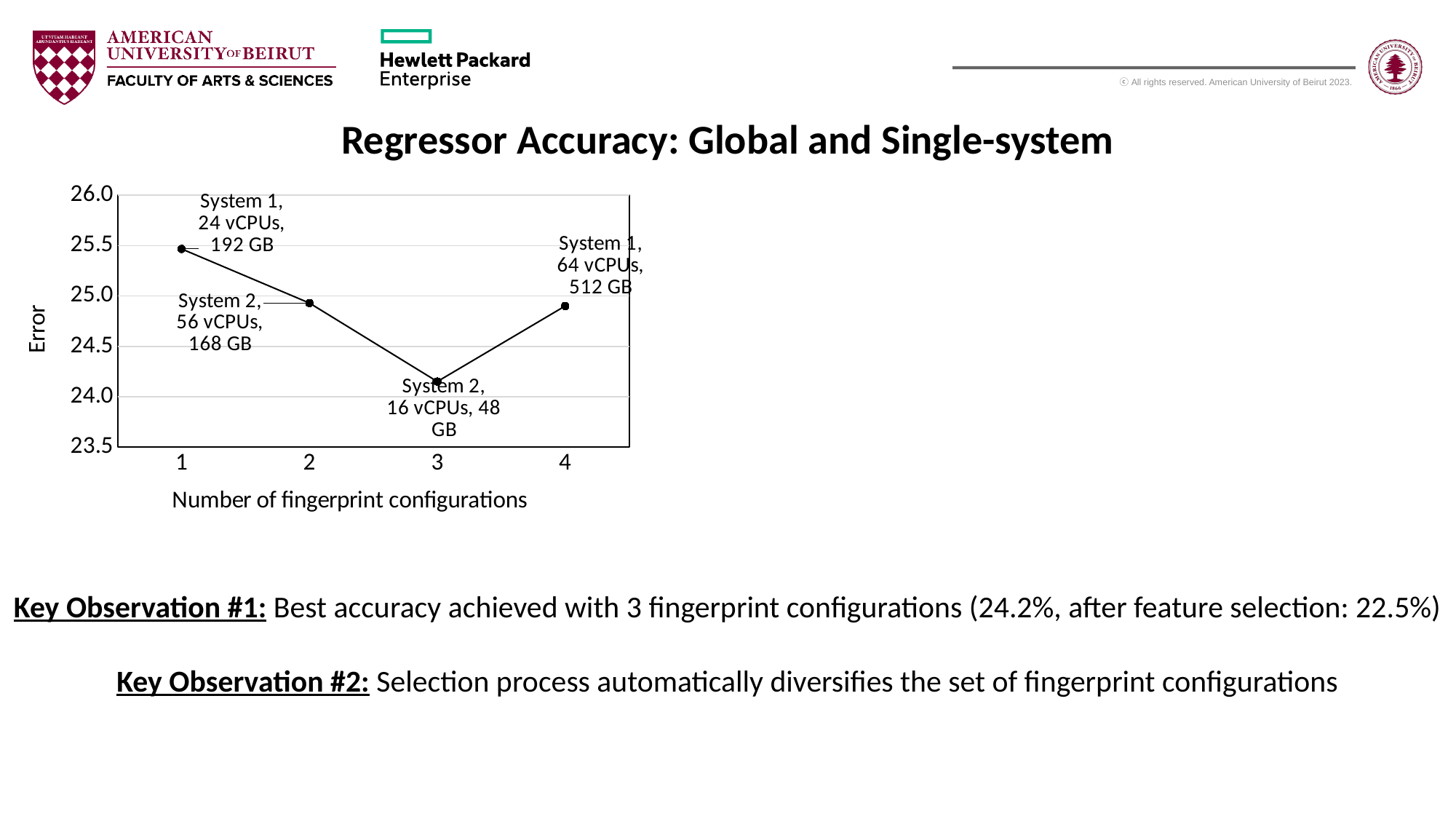
Is the error for 3 fingerprint configurations greater or less than 24.5? less What kind of chart is shown on the slide? Line chart Is the error for 1 fingerprint configuration greater or less than 25.0? greater Is the error for 3 fingerprint configurations greater or less than 24.0? greater Which has a higher error: 1 fingerprint configuration or 3 fingerprint configurations? 1 fingerprint configuration How many data points are plotted on the chart? 4 At which number of fingerprint configurations is the error highest? 1 At which number of fingerprint configurations is the error lowest? 3 Which system configuration is labelled at the point for 3 fingerprint configurations? System 2, 16 vCPUs, 48 GB What is the label of the x axis? Number of fingerprint configurations How does the error change as the number of fingerprint configurations goes from 1 to 3? It falls